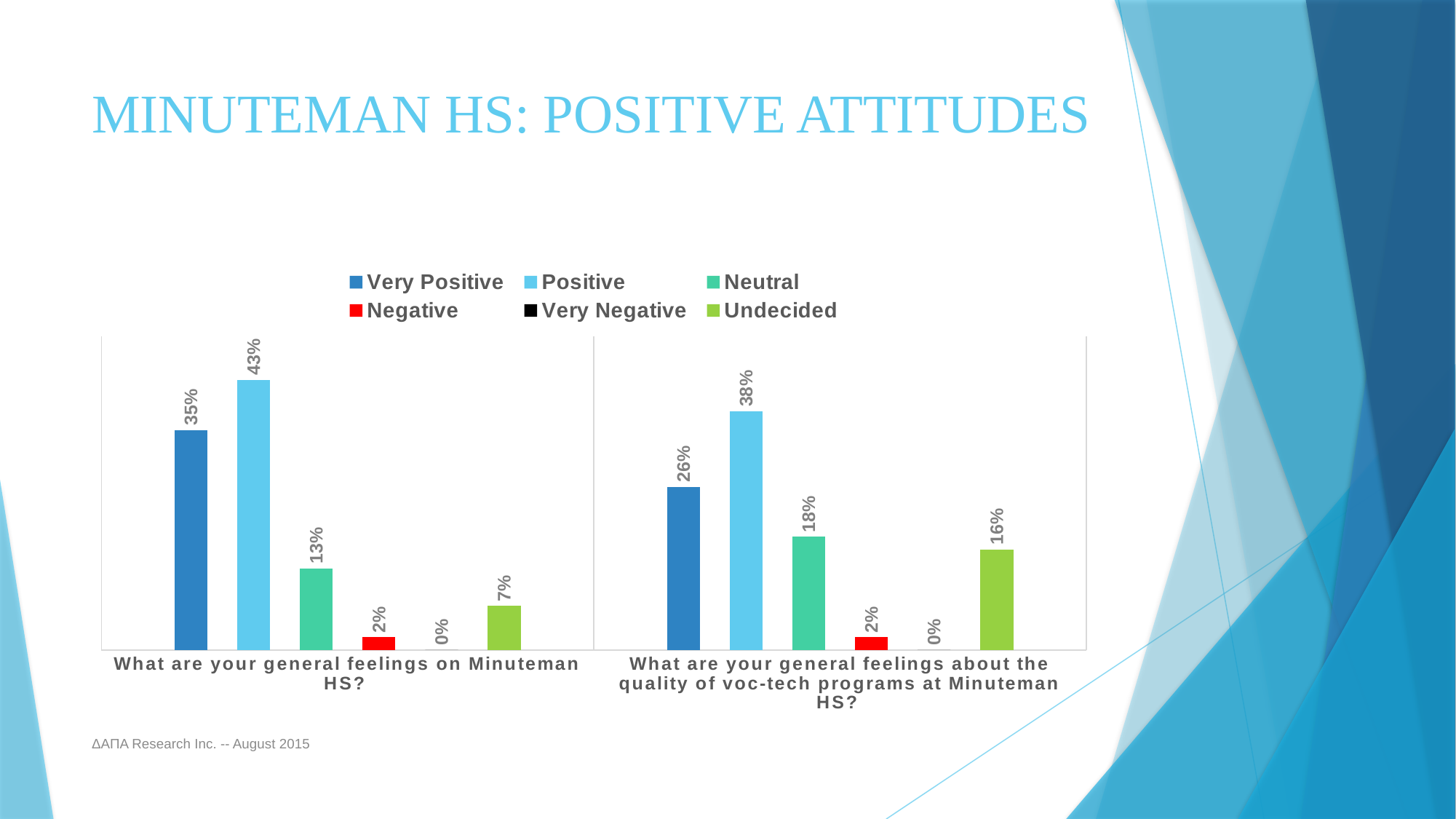
What percentage of respondents answered "Positive" to "What are your general feelings on Minuteman HS?" 43% Which response has the lowest value for the question about the quality of voc-tech programs at Minuteman HS? Very Negative How many series does the legend list? 6 What is the "Undecided" value for the question about the quality of voc-tech programs at Minuteman HS? 16% Which response has the highest value for "What are your general feelings on Minuteman HS?" Positive What is the difference between the "Positive" and "Very Positive" values for "What are your general feelings on Minuteman HS?" 8% What is the "Neutral" value for "What are your general feelings on Minuteman HS?" 13% How many survey questions (categories) are shown on the x axis? 2 What percentage answered "Very Positive" to "What are your general feelings about the quality of voc-tech programs at Minuteman HS?" 26% What kind of chart is shown on the slide? Bar chart Is the "Undecided" value larger for the general feelings question or for the voc-tech programs question? The voc-tech programs question What colour represents the "Negative" series in the legend? Red